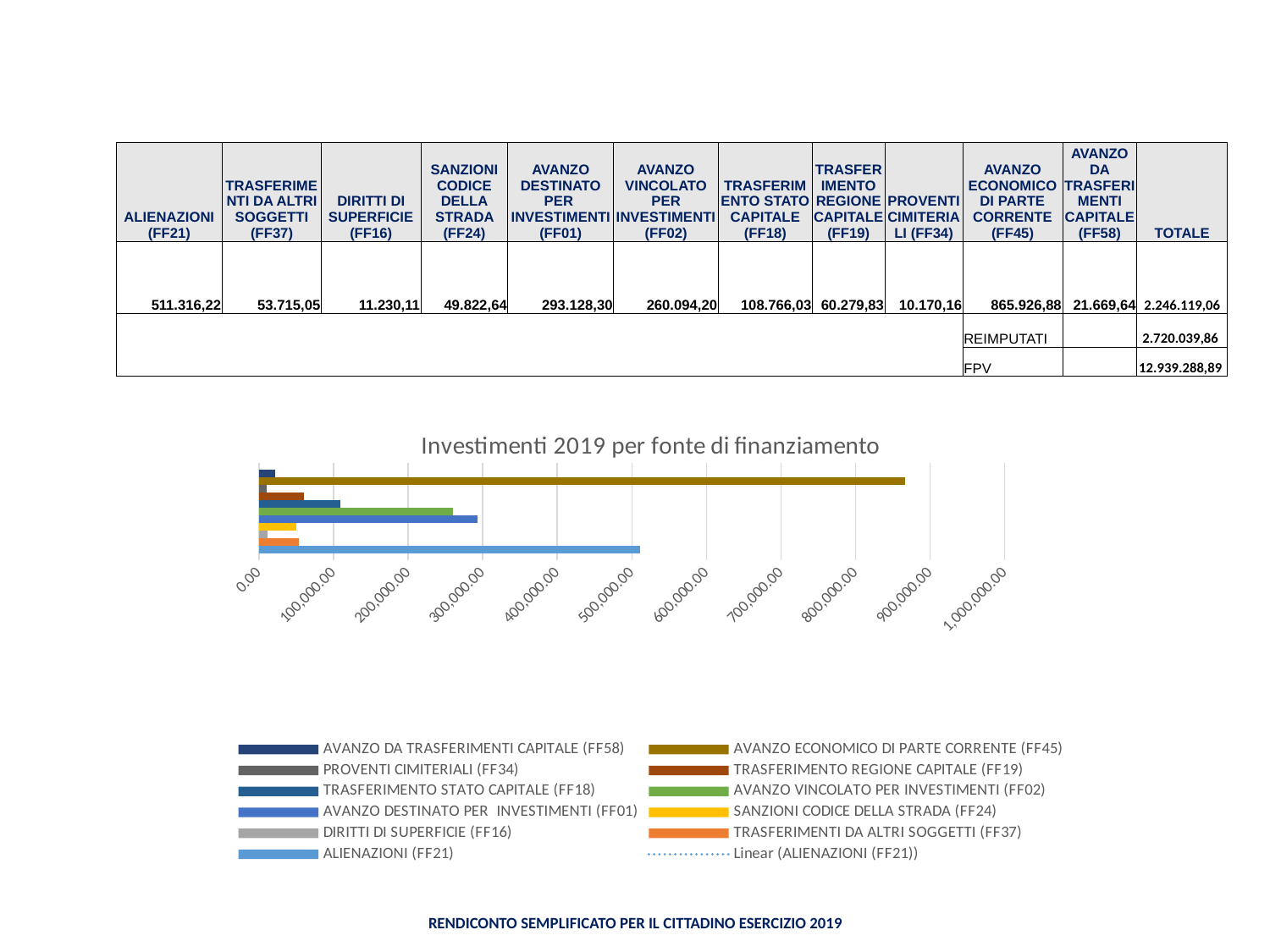
Is the bar for ALIENAZIONI (FF21) greater or less than 400,000.00? greater Is the bar for AVANZO VINCOLATO PER INVESTIMENTI (FF02) greater or less than 200,000.00? greater Is the bar for AVANZO ECONOMICO DI PARTE CORRENTE (FF45) greater or less than 800,000.00? greater According to the table, what is the value for ALIENAZIONI (FF21)? 511.316,22 What is the title of the chart? Investimenti 2019 per fonte di finanziamento What kind of chart is shown on the slide? bar chart Which bar is longer: ALIENAZIONI (FF21) or AVANZO DESTINATO PER INVESTIMENTI (FF01)? ALIENAZIONI (FF21) Which funding source has the longest bar in the chart? AVANZO ECONOMICO DI PARTE CORRENTE (FF45) What is the highest value shown on the chart's horizontal axis? 1,000,000.00 According to the table, what is the value for AVANZO ECONOMICO DI PARTE CORRENTE (FF45)? 865.926,88